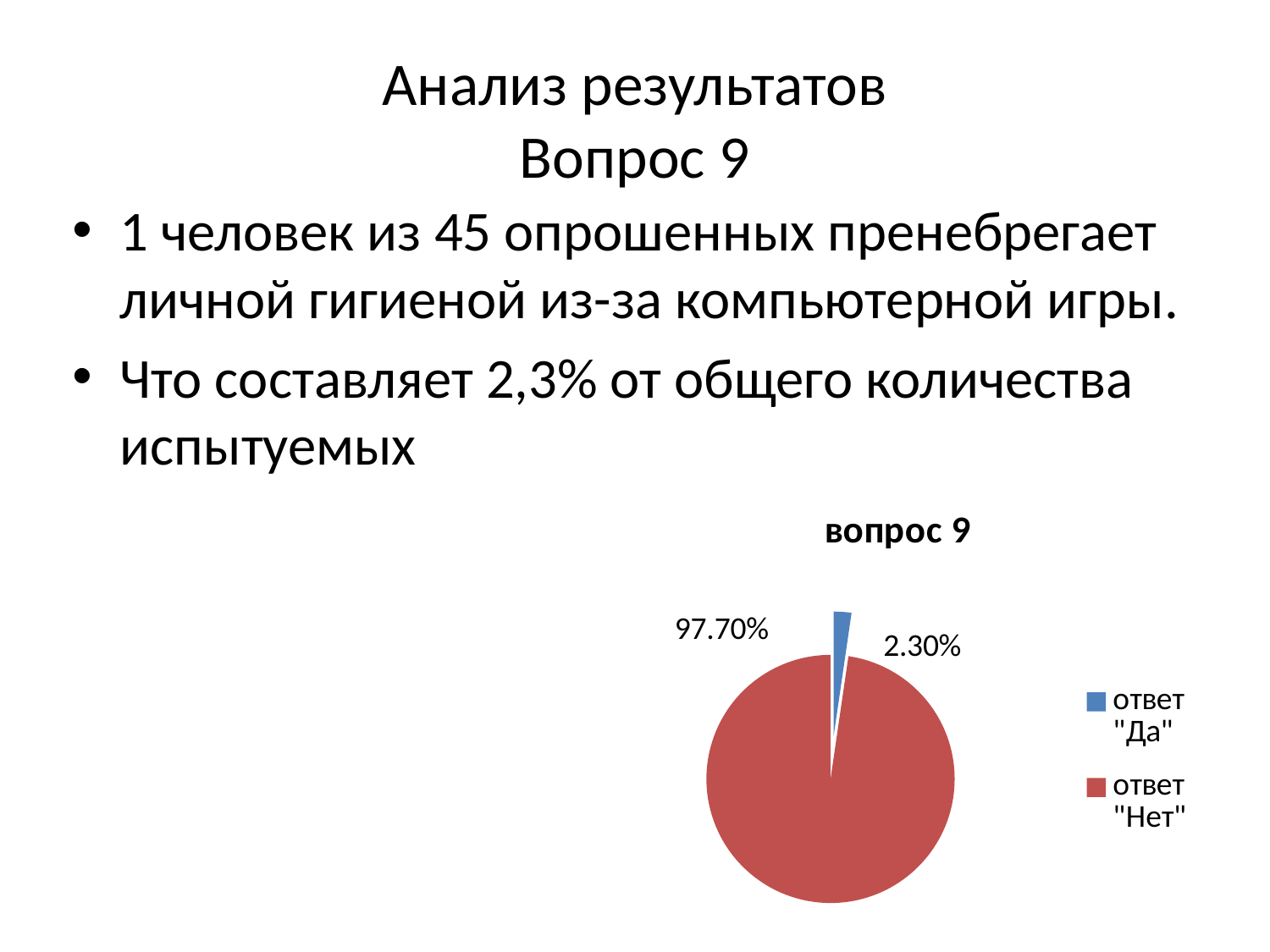
What is the chart's title? вопрос 9 How many entries does the legend list? 2 What is the difference between the shares for ответ "Нет" and ответ "Да"? 95.40% What kind of chart is shown on the slide? pie chart Which is larger, the share for ответ "Да" or the share for ответ "Нет"? ответ "Нет" What share of the pie is labelled for ответ "Нет"? 97.70% What share of the pie is labelled for ответ "Да"? 2.30% How many slices does the pie chart have? 2 Which slice of the pie is the largest? ответ "Нет" What colour is the slice for ответ "Нет"? red Which slice of the pie is the smallest? ответ "Да"